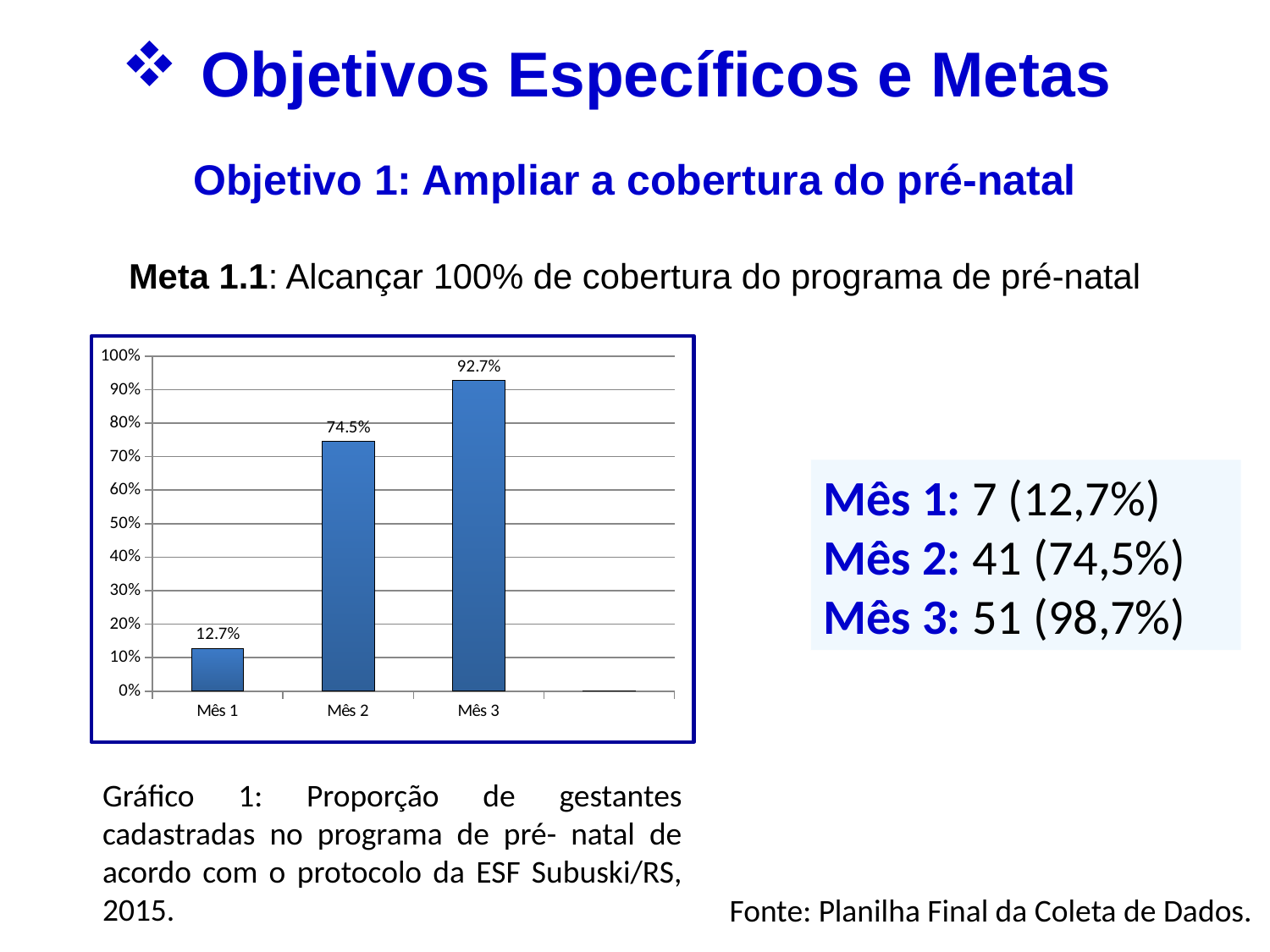
What is the value shown for Mês 1 in the chart? 12.7% What is the difference between the values for Mês 2 and Mês 1? 61.8% What is the value shown for Mês 3 in the chart? 92.7% How many months are labeled on the x axis of the chart? 3 What is the difference between the values for Mês 3 and Mês 2? 18.2% Is the value for Mês 3 greater or less than 90%? greater Which month has the lowest bar in the chart? Mês 1 Which month has the highest bar in the chart? Mês 3 Do the values rise or fall from Mês 1 to Mês 3? rise What kind of chart is shown on the slide? bar chart What is the value shown for Mês 2 in the chart? 74.5% Which is larger, the value for Mês 2 or the value for Mês 1? Mês 2